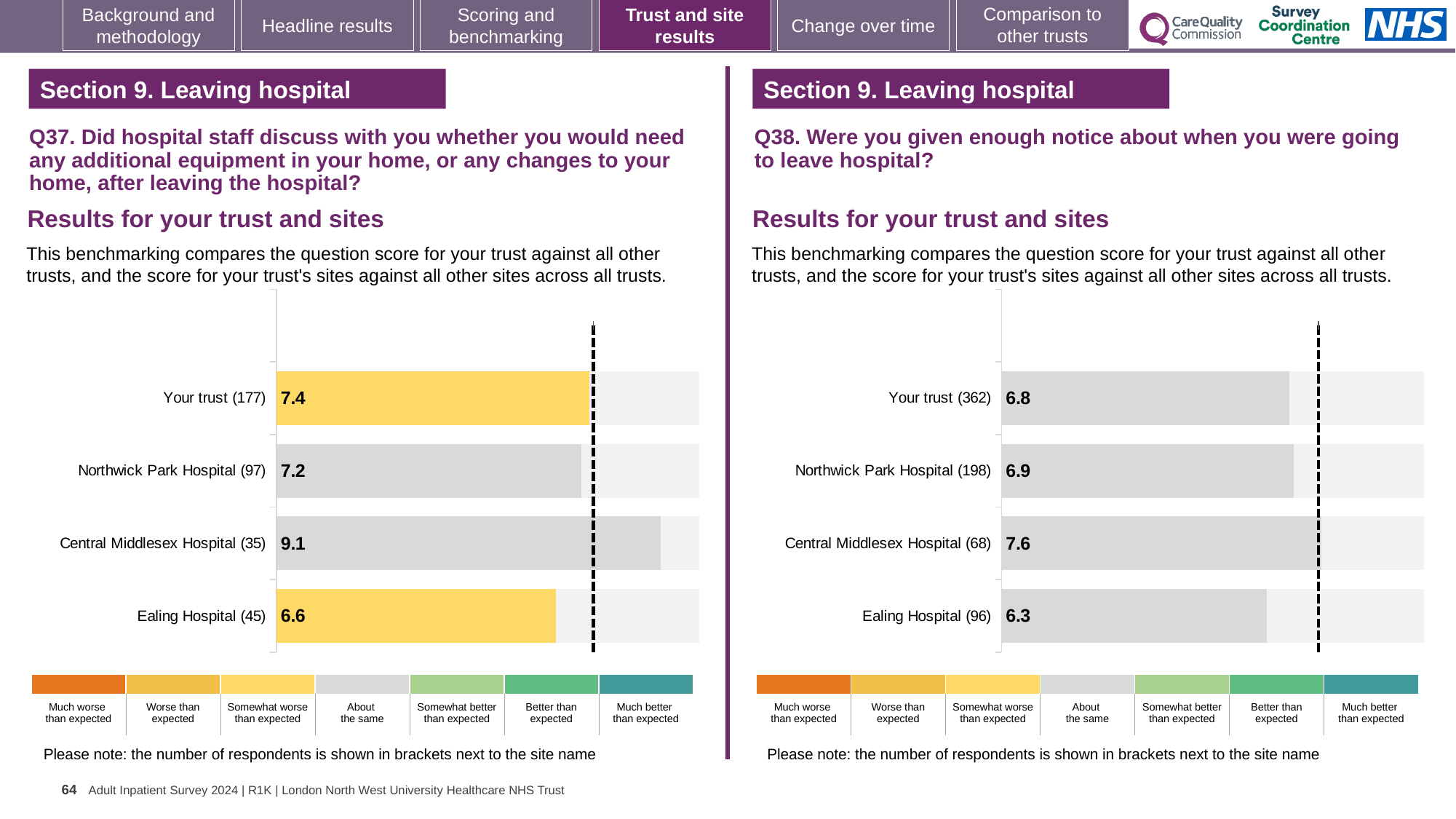
In the Q37 chart on the left, what is the difference between the scores for Central Middlesex Hospital and Ealing Hospital? 2.5 In the Q37 chart on the left, which benchmark category does the colour of the Ealing Hospital bar correspond to? Somewhat worse than expected In the Q37 chart on the left, what is the score for Central Middlesex Hospital? 9.1 In the Q38 chart on the right, which site has the highest score? Central Middlesex Hospital In the Q37 chart on the left, which site has the lowest score? Ealing Hospital What type of chart is used for the Q37 results on the left? Bar chart In the Q38 chart on the right, what is the difference between the scores for Central Middlesex Hospital and Your trust? 0.8 How many bars are plotted in the Q38 chart on the right? 4 In the Q38 chart on the right, which is larger: the score for Your trust or the score for Northwick Park Hospital? Northwick Park Hospital In the Q38 chart on the right, what is the score for Ealing Hospital? 6.3 In the Q37 chart on the left, what is the score for Your trust? 7.4 In the Q37 chart on the left, how many respondents are shown in brackets for Northwick Park Hospital? 97